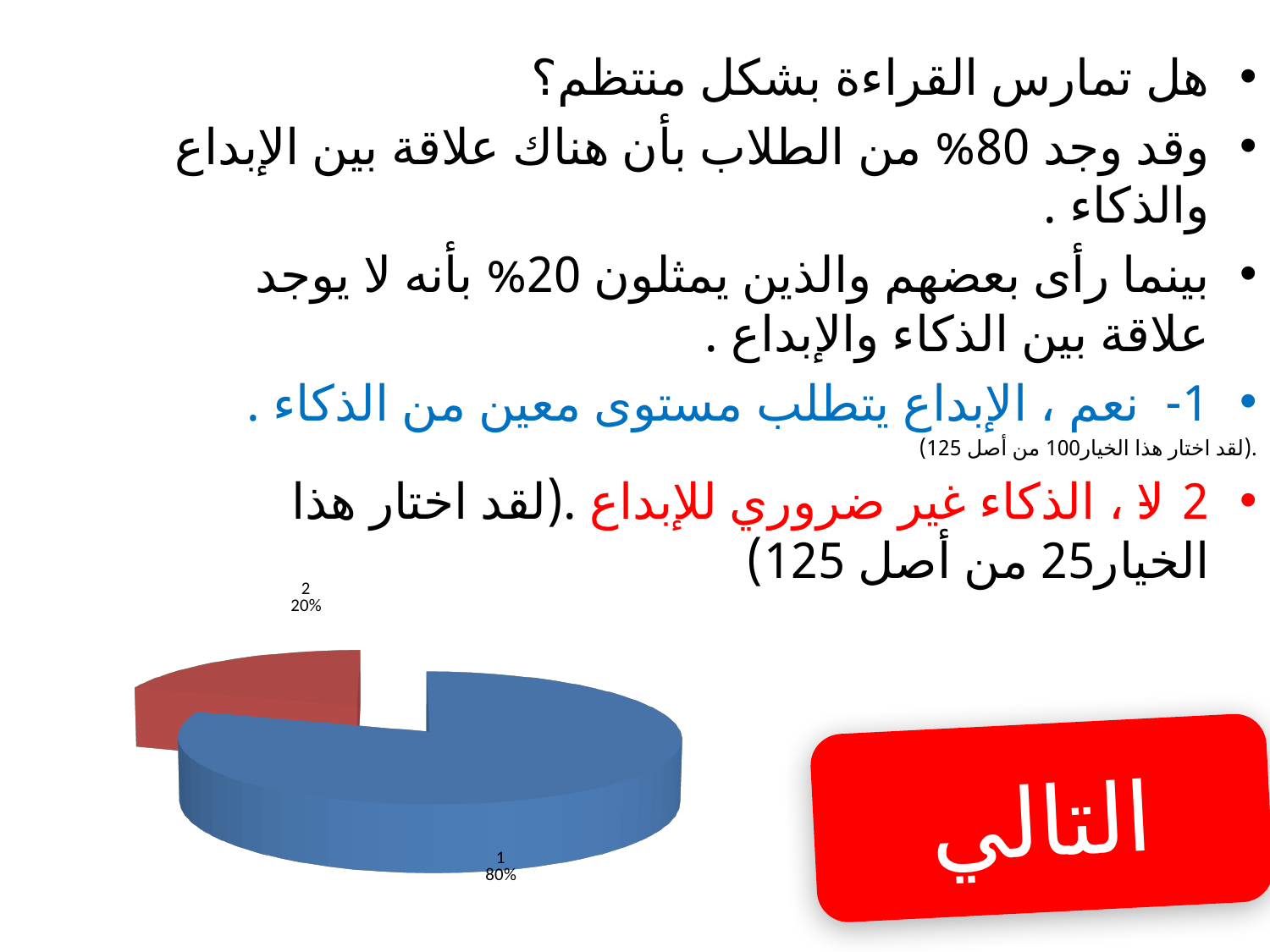
How many slices does the pie chart have? 2 What is the difference in percentage points between slice 1 and slice 2? 60% What kind of chart is shown on the slide? pie chart Which slice of the pie chart is the largest? 1 What colour is the slice labelled 1 in the pie chart? blue Which is larger in the pie chart, slice 1 or slice 2? 1 What is the total of the two percentages shown on the pie chart? 100% Which slice of the pie chart is the smallest? 2 What share of the pie does slice 2 represent? 20% What share of the pie does slice 1 represent? 80% What colour is the slice labelled 2 in the pie chart? red